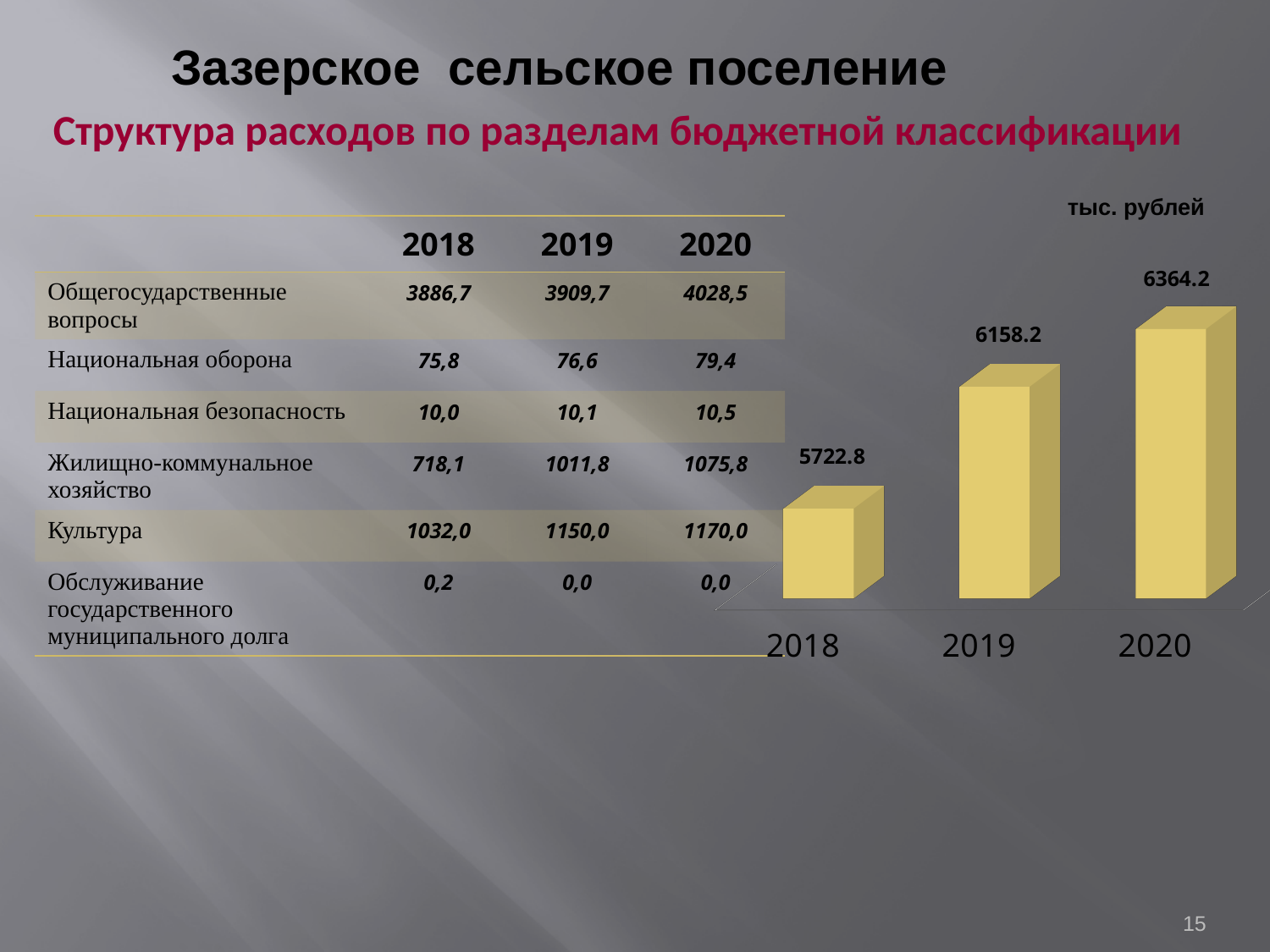
What is the value shown for 2020 in the bar chart? 6364.2 Which year has the lowest bar in the chart? 2018 Which year has the highest bar in the chart? 2020 What is the value shown for 2018 in the bar chart? 5722.8 What is the difference between the 2020 and 2019 values in the bar chart? 206.0 Do the values in the bar chart rise or fall from 2018 to 2020? rise Which is larger in the bar chart, the value for 2018 or the value for 2019? 2019 How many bars are shown in the chart? 3 What type of chart is shown on the slide? bar chart What is the difference between the 2019 and 2018 values in the bar chart? 435.4 What unit is indicated above the bar chart? тыс. рублей What is the value shown for 2019 in the bar chart? 6158.2